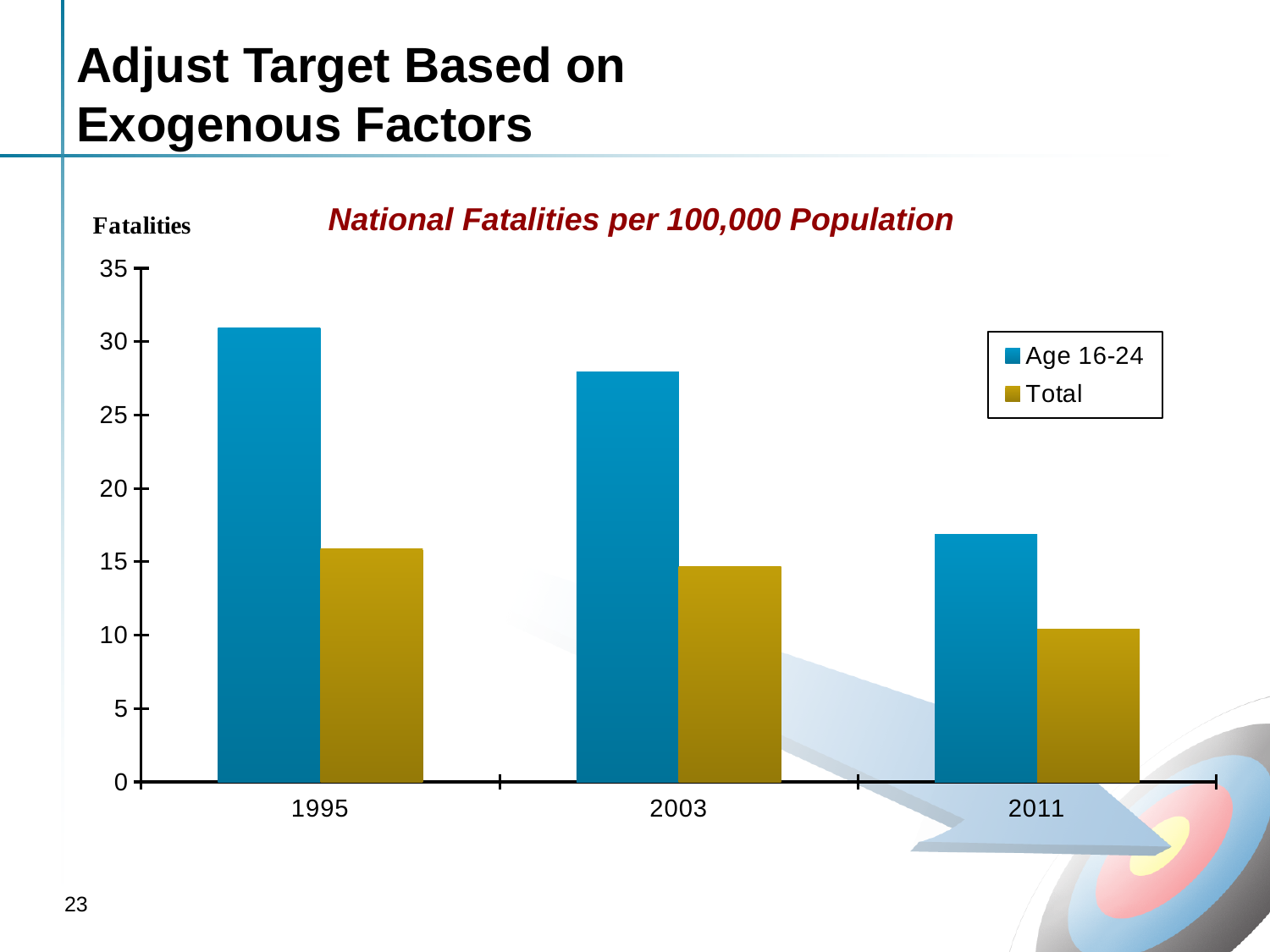
Is the Age 16-24 value for 1995 greater or less than 25? greater How many years are shown on the x axis? 3 Which is larger in 2003, the Age 16-24 value or the Total value? Age 16-24 Is the Total value for 2003 greater or less than 10? greater Is the Age 16-24 value for 2011 greater or less than 20? less What kind of chart is shown on the slide? bar chart Which year has the highest Age 16-24 value? 1995 What is the title of the chart? National Fatalities per 100,000 Population Do the Age 16-24 values rise or fall from 1995 to 2011? fall Which series is shown in blue? Age 16-24 Which year has the lowest Total value? 2011 How many series does the legend list? 2